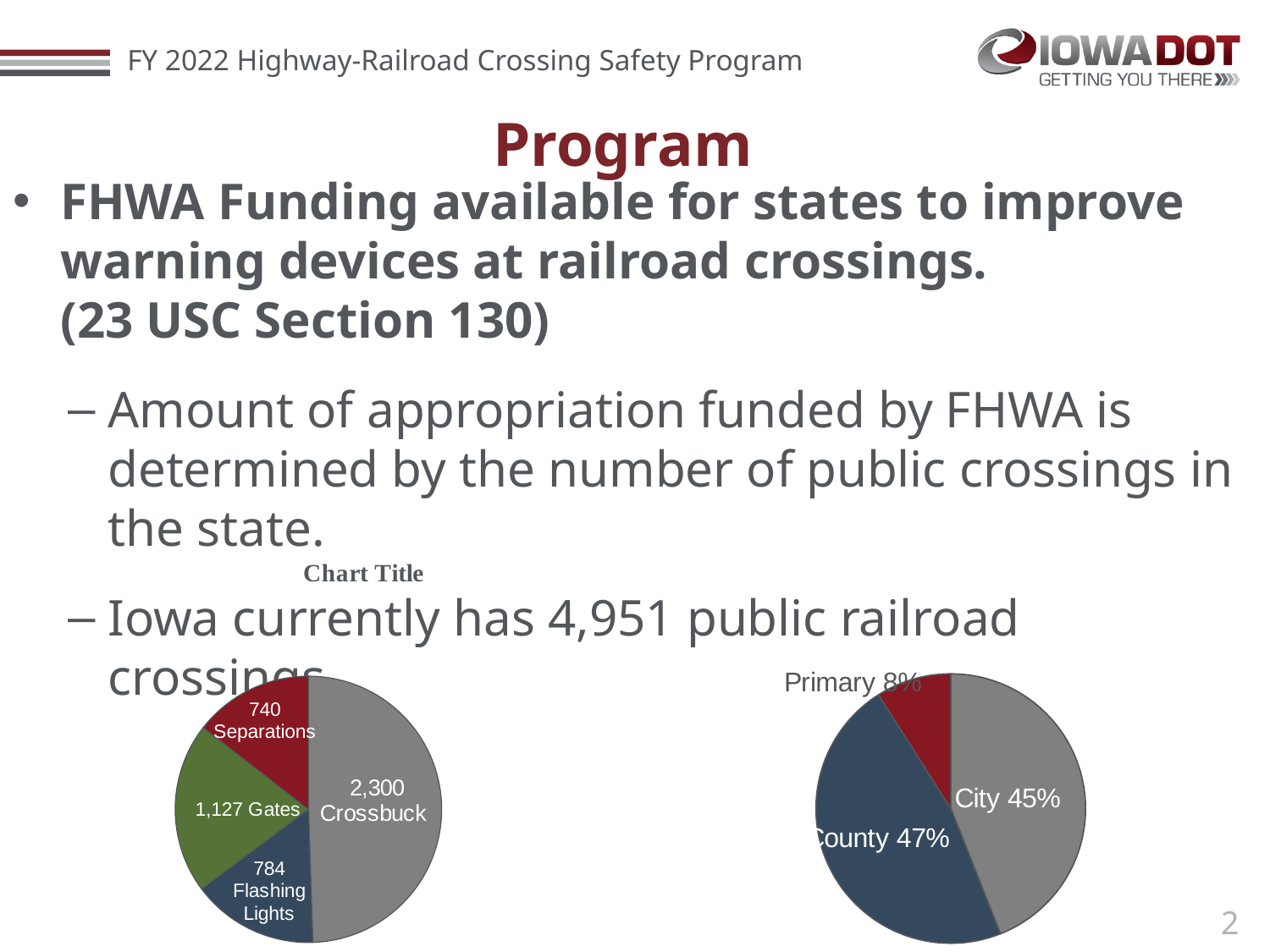
In the right pie chart, which category has the smallest share? Primary In the right pie chart, what share does County have? 47% How many slices does the left pie chart have? 4 In the left pie chart, what is the value for Gates? 1,127 In the right pie chart, what share does City have? 45% In the left pie chart, what is the value for Flashing Lights? 784 What kind of chart is the left chart titled "Chart Title"? pie chart In the left pie chart, what is the value for Crossbuck? 2,300 In the left pie chart, what is the difference between the Crossbuck value and the Gates value? 1,173 In the left pie chart, which category has the smallest value? Separations In the left pie chart, which category has the largest value? Crossbuck In the left pie chart, which is larger: Gates or Flashing Lights? Gates